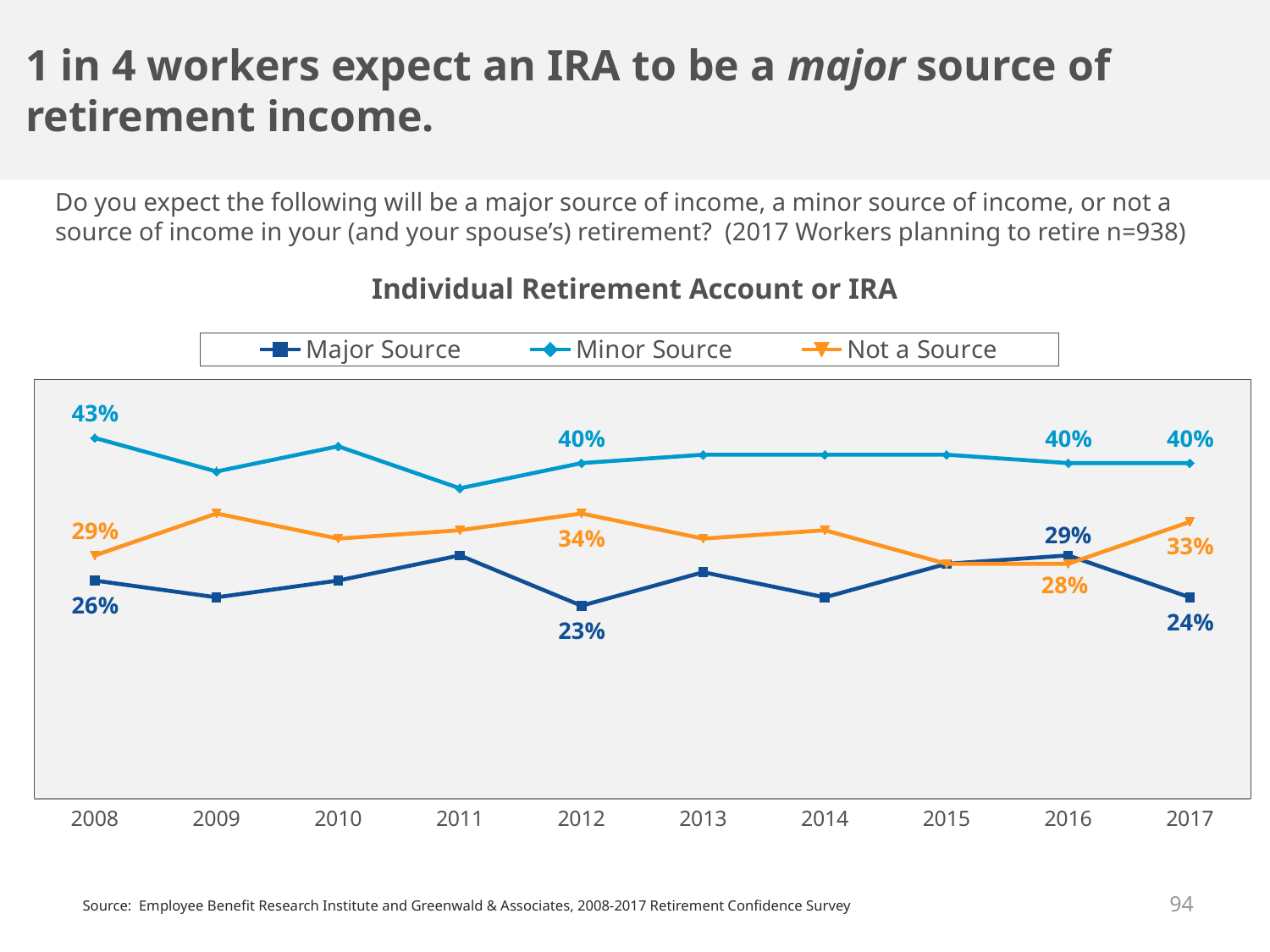
What is the value for Not a Source in 2017? 33% What is the value for Major Source in 2012? 23% How many years are shown on the x axis? 10 What is the difference between Minor Source and Major Source in 2017? 16 percentage points What is the value for Minor Source in 2008? 43% Which is larger in 2008, Not a Source or Major Source? Not a Source What type of chart is shown on the slide? Line chart How many series does the legend list? 3 What is the difference between Not a Source in 2012 and Not a Source in 2016? 6 percentage points Which series has the highest value in 2017? Minor Source What is the value for Major Source in 2016? 29% What is the title of the chart? Individual Retirement Account or IRA